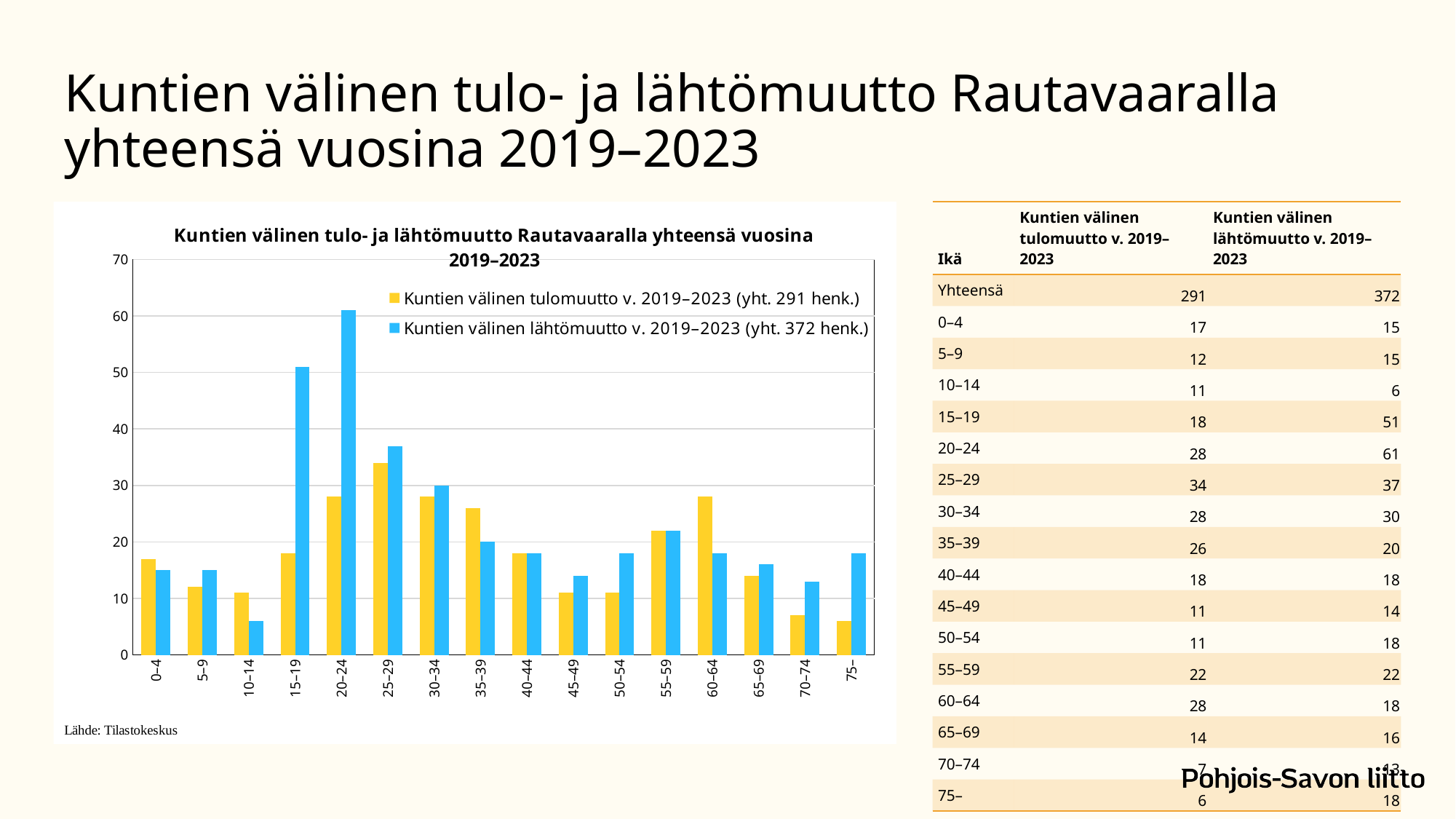
For the 60–64 age group, which is larger: tulomuutto or lähtömuutto? tulomuutto How many series does the chart legend list? 2 Is the value of Kuntien välinen lähtömuutto for the 15–19 age group greater or less than 40? greater What colour are the bars for Kuntien välinen lähtömuutto in the chart? blue Which age group has the highest value for Kuntien välinen lähtömuutto? 20–24 According to the legend, what is the total number of people for Kuntien välinen tulomuutto v. 2019–2023? 291 henk. Which age group has the lowest value for Kuntien välinen lähtömuutto? 10–14 What is the difference between lähtömuutto and tulomuutto for the 15–19 age group? 33 What is the value of Kuntien välinen lähtömuutto for the 20–24 age group? 61 How many age groups are shown on the x axis of the chart? 16 What kind of chart is shown on the slide? bar chart What is the value of Kuntien välinen tulomuutto for the 25–29 age group? 34